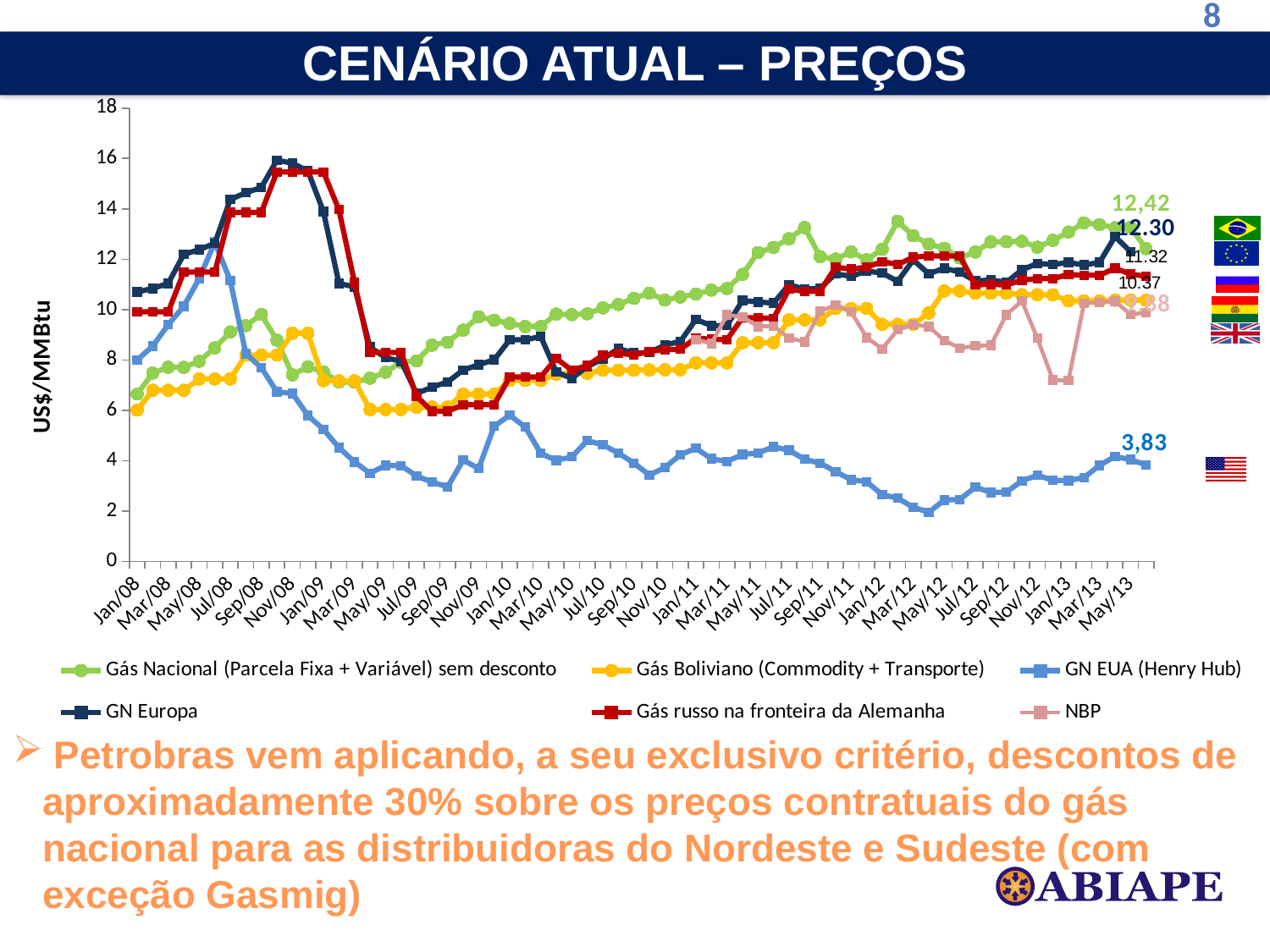
Which series has the highest value at the end of the chart (May/13)? Gás Nacional (Parcela Fixa + Variável) sem desconto What is the final labelled value for Gás Nacional (Parcela Fixa + Variável) sem desconto? 12,42 What is the final labelled value for GN EUA (Henry Hub)? 3,83 What is the label on the vertical axis? US$/MMBtu How many series does the legend list? 6 What kind of chart is shown on the slide? line chart Is the value for GN EUA (Henry Hub) in Mar/12 greater or less than 4? less Does the GN EUA (Henry Hub) series overall rise or fall from Jan/08 to May/13? fall At the end of the chart, which is larger: GN Europa or Gás russo na fronteira da Alemanha? GN Europa Which series has the lowest value at the end of the chart (May/13)? GN EUA (Henry Hub) What is the difference between the final labelled values of Gás Nacional (12,42) and GN EUA (Henry Hub) (3,83)? 8,59 What is the final labelled value for GN Europa? 12.30